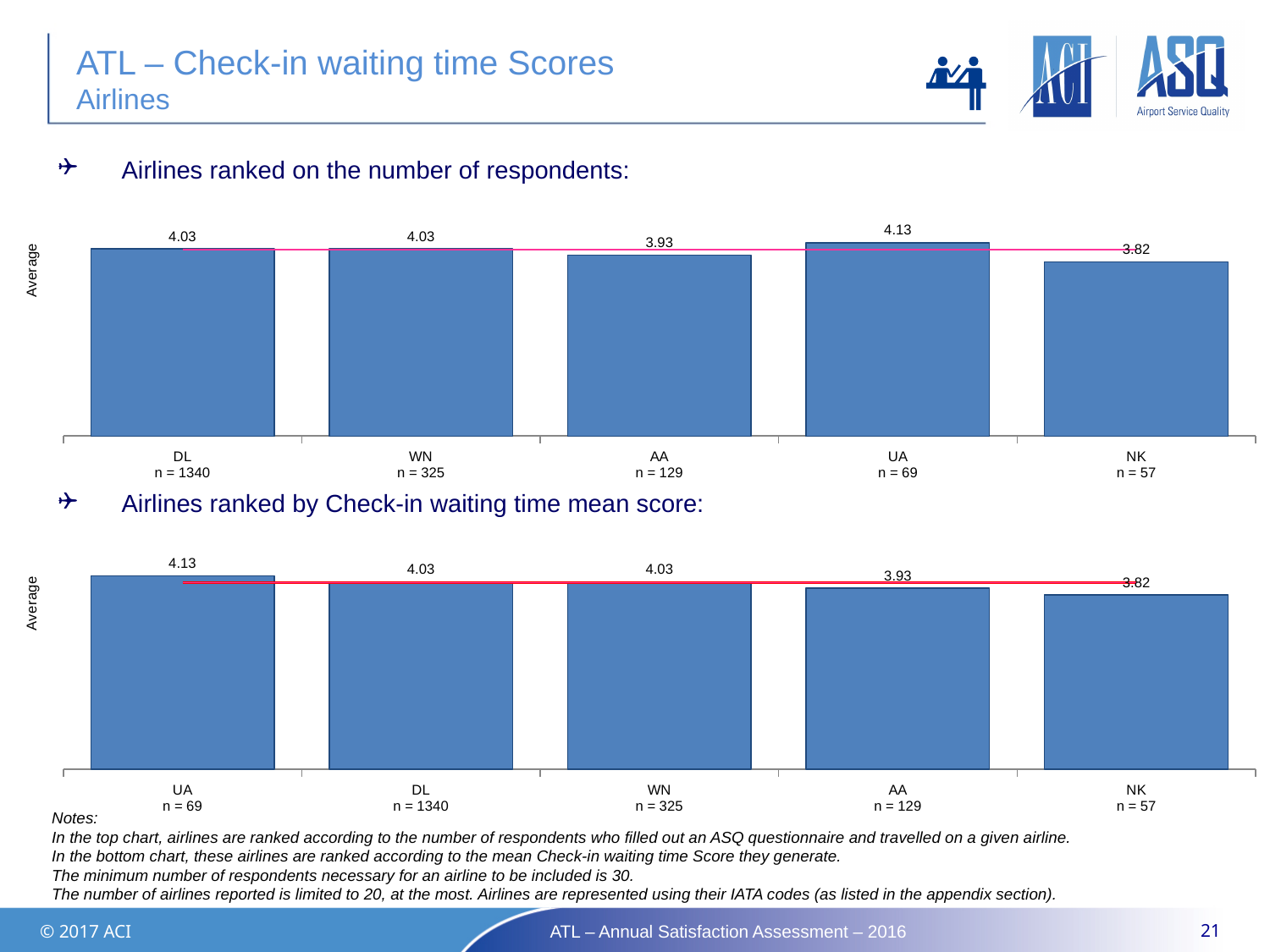
In the bottom chart (airlines ranked by Check-in waiting time mean score), what is the difference between the average scores of UA and NK? 0.31 In the bottom chart (airlines ranked by Check-in waiting time mean score), what is the average score for NK? 3.82 How many airlines are shown in the bottom chart (airlines ranked by Check-in waiting time mean score)? 5 What type of chart is the top chart (airlines ranked on the number of respondents)? Bar chart In the top chart (airlines ranked on the number of respondents), what is the difference between the average scores of AA and NK? 0.11 In the top chart (airlines ranked on the number of respondents), how many respondents (n) are shown for DL? n = 1340 In the top chart (airlines ranked on the number of respondents), which airline has the lowest average score? NK In the bottom chart (airlines ranked by Check-in waiting time mean score), do the average scores rise or fall from left to right? Fall In the top chart (airlines ranked on the number of respondents), what is the average score for DL? 4.03 In the top chart (airlines ranked on the number of respondents), which has the higher average score, UA or AA? UA In the bottom chart (airlines ranked by Check-in waiting time mean score), which airline has the highest average score? UA In the top chart (airlines ranked on the number of respondents), what is the average score for UA? 4.13